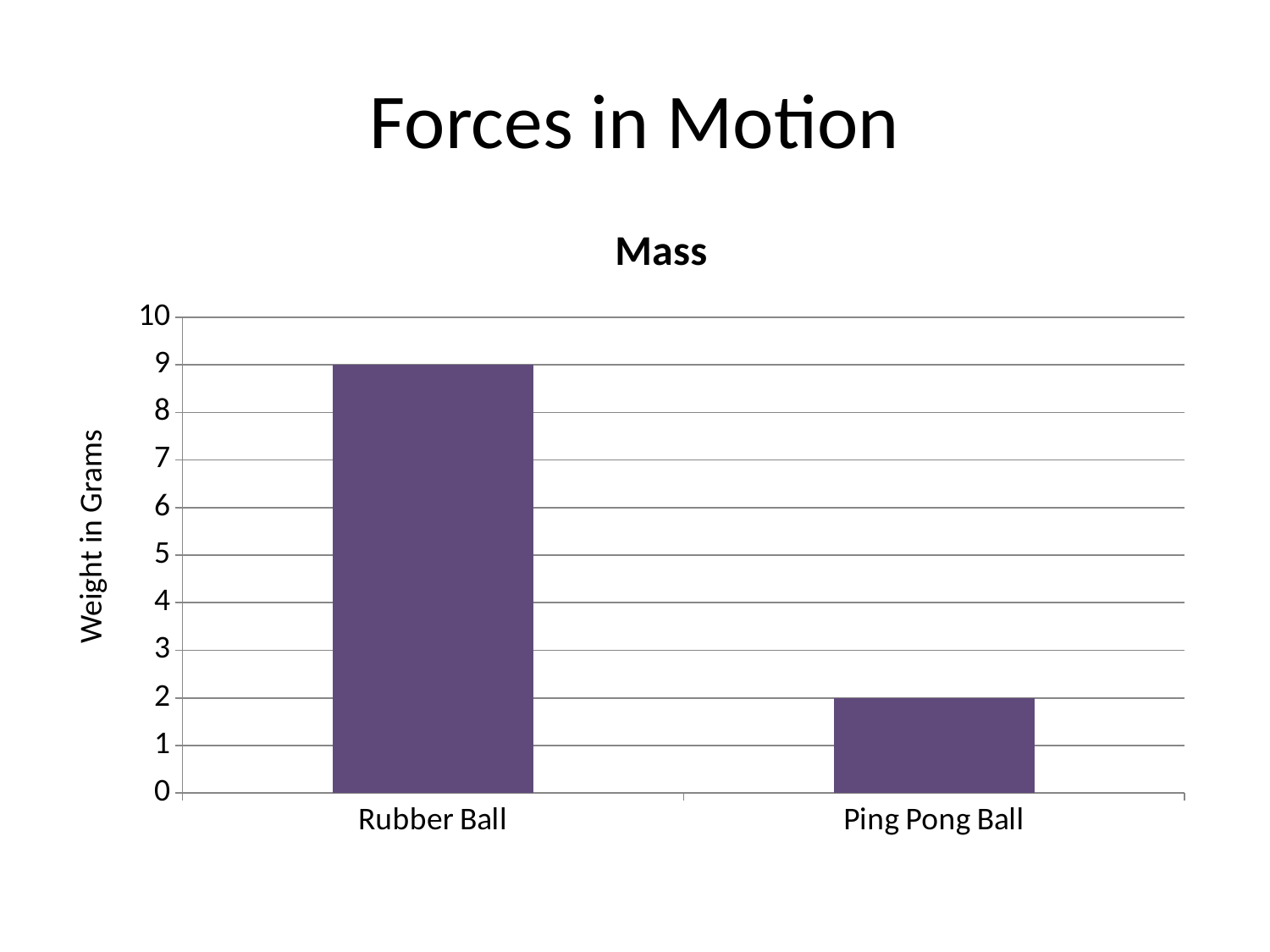
Which category has the lowest value? Ping Pong Ball What is the title of the chart? Mass Is the value for Ping Pong Ball greater or less than 5? less Is the value for Rubber Ball greater or less than 5? greater How many categories are shown on the x axis? 2 What is the value for Ping Pong Ball? 2 Which is larger, the value for Rubber Ball or the value for Ping Pong Ball? Rubber Ball What is the difference between the values for Rubber Ball and Ping Pong Ball? 7 What is the label of the y axis? Weight in Grams What kind of chart is this? bar chart Which category has the highest value? Rubber Ball What is the value for Rubber Ball? 9